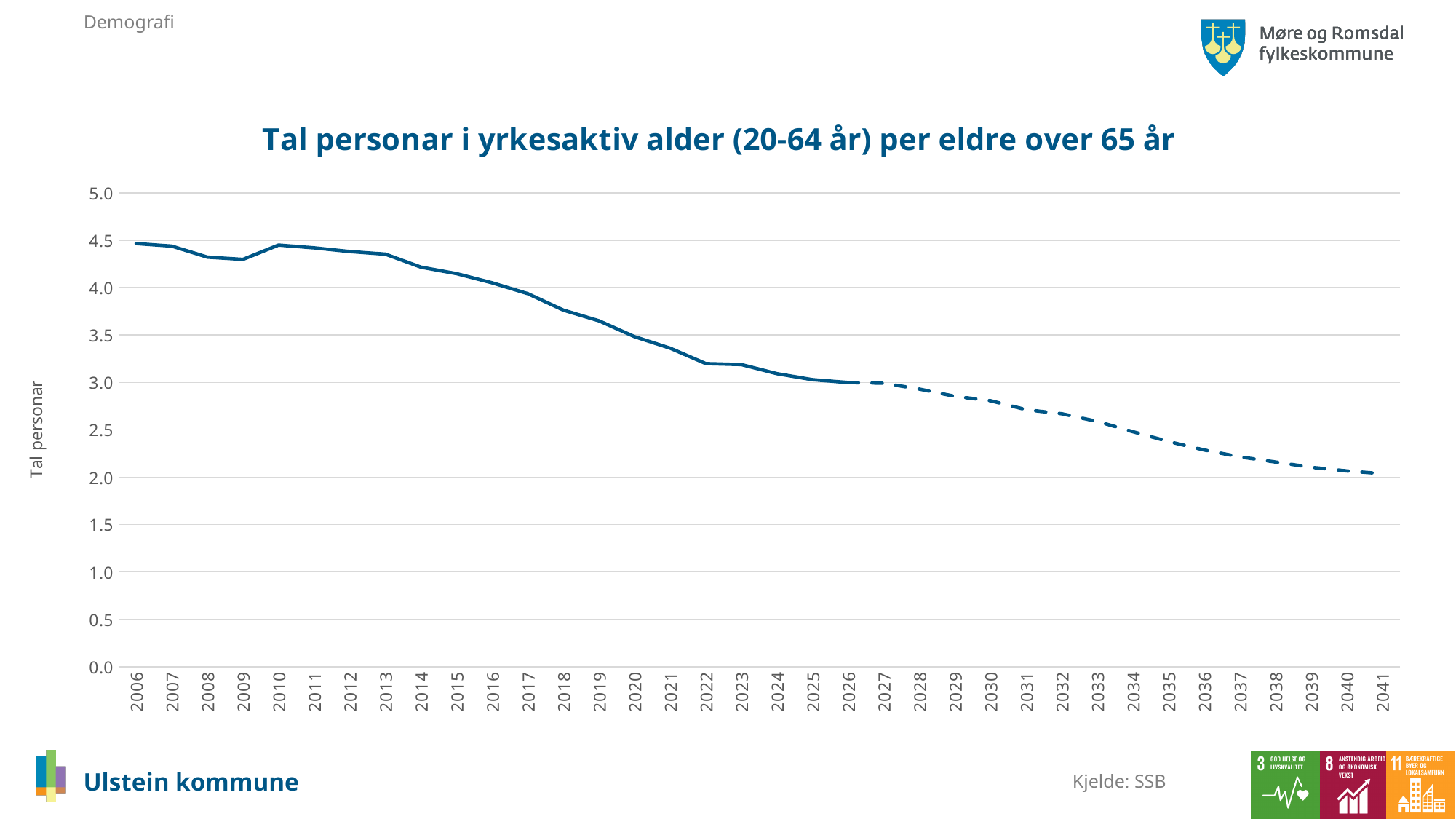
Is the value for 2036 greater or less than 2.5? less Which year has the larger value, 2010 or 2020? 2010 Is the value for 2041 greater or less than 2.5? less What is the title of the chart? Tal personar i yrkesaktiv alder (20-64 år) per eldre over 65 år Do the values generally rise or fall from 2006 to 2041? fall Which year has the larger value, 2030 or 2013? 2013 Which year has the lowest value on the chart? 2041 How many years are shown along the x axis of the chart? 36 Is the value for 2022 greater or less than 3.0? greater What kind of chart is shown on the slide? line chart What is the label on the vertical axis of the chart? Tal personar